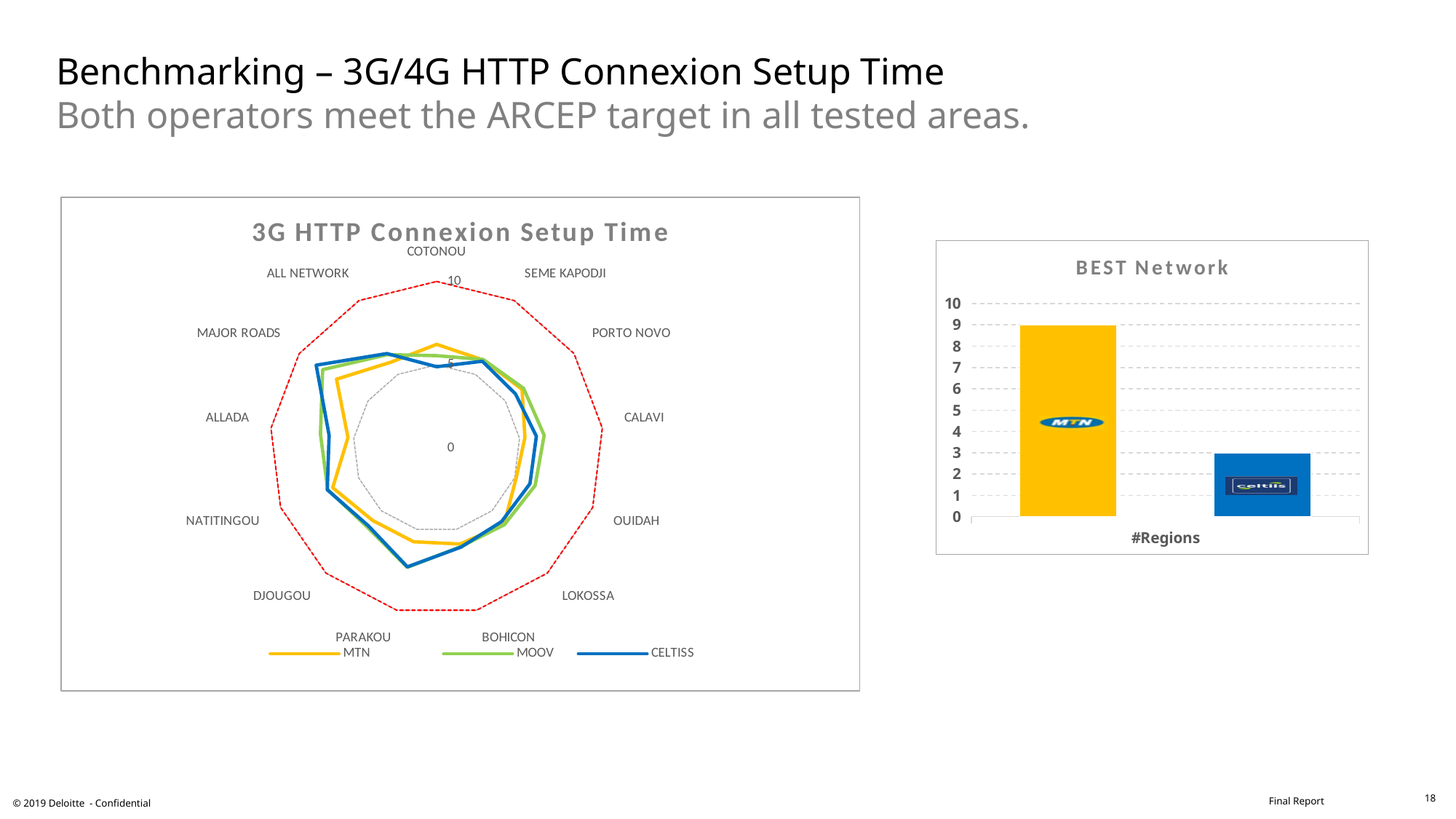
What kind of chart is the 3G HTTP Connexion Setup Time chart? radar chart In the BEST Network chart, which bar is higher, MTN or Celtis? MTN In the BEST Network chart, which network has the highest bar? MTN In the BEST Network chart, what is the value of the Celtis bar? 3 In the BEST Network chart, what is the difference between the MTN bar and the Celtis bar? 6 What kind of chart is the BEST Network chart? bar chart In the 3G HTTP Connexion Setup Time chart, is the MTN value for COTONOU greater or less than 10? less How many series does the legend of the 3G HTTP Connexion Setup Time chart list? 3 What is the category axis label shown under the bars in the BEST Network chart? #Regions In the BEST Network chart, what is the value of the MTN bar? 9 How many categories (axes) are plotted on the 3G HTTP Connexion Setup Time radar chart? 13 In the 3G HTTP Connexion Setup Time chart, is the CELTISS value for DJOUGOU greater or less than 5? greater